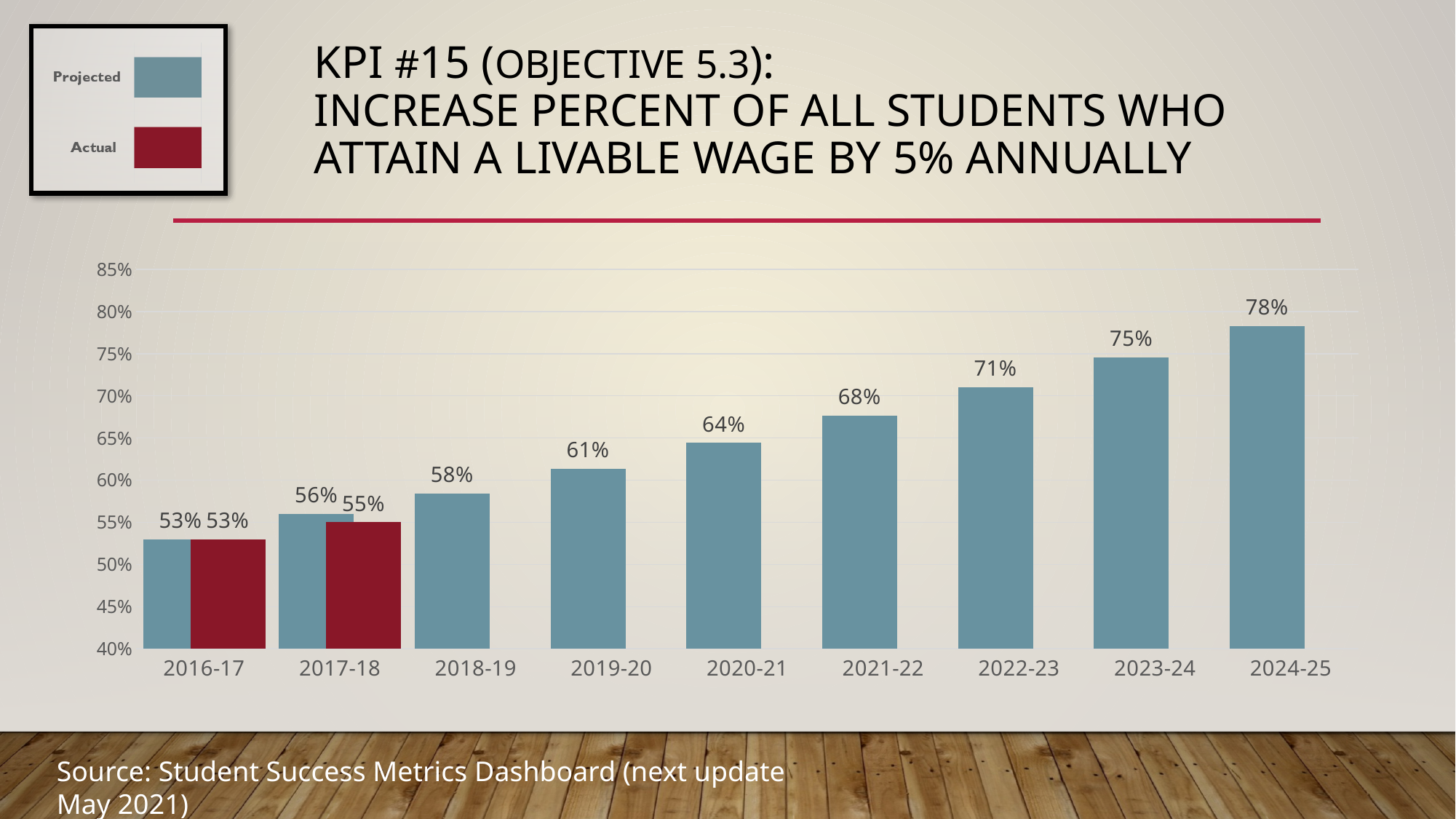
How many years are shown on the x axis? 9 What is the Projected value for 2024-25? 78% Which is larger, the Projected value for 2017-18 or the Actual value for 2017-18? Projected What kind of chart is shown on the slide? Bar chart Which year has the lowest Projected value? 2016-17 What is the Projected value for 2020-21? 64% Do the Projected values rise or fall from 2016-17 to 2024-25? Rise What is the Actual value for 2017-18? 55% What is the difference between the Projected values for 2024-25 and 2016-17? 25% How many series does the legend list? 2 Which year has the highest Projected value? 2024-25 What is the difference between the Projected and Actual values for 2017-18? 1%